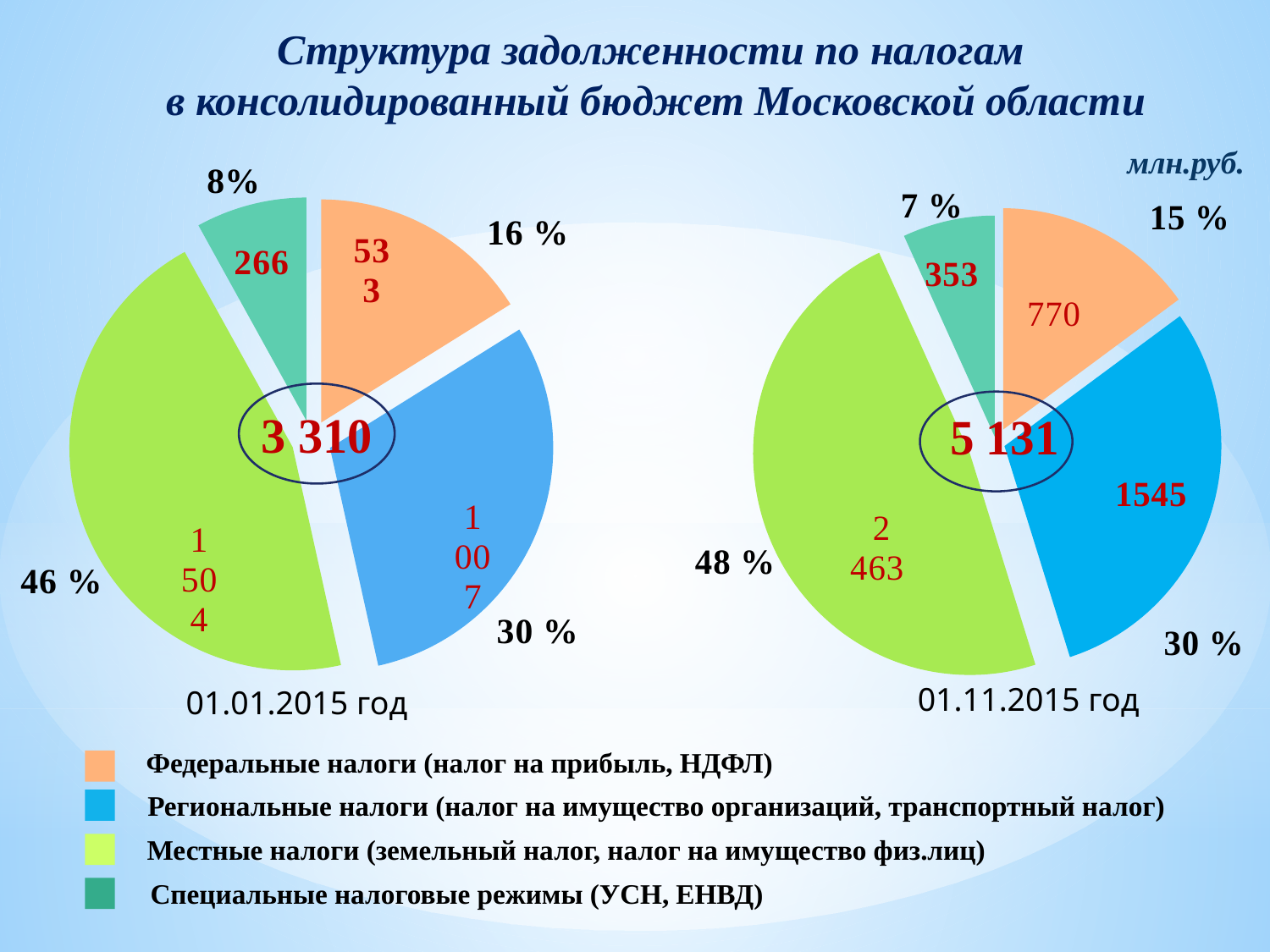
In the 01.11.2015 pie chart, what is the total shown in the centre? 5 131 In the 01.01.2015 pie chart, what share does Специальные налоговые режимы have? 8% In the 01.11.2015 pie chart, which category has the smallest slice? Специальные налоговые режимы In the 01.01.2015 pie chart, which category has the largest slice? Местные налоги In the 01.11.2015 pie chart, what share does Местные налоги have? 48 % Which is larger: Федеральные налоги in the 01.01.2015 chart or Федеральные налоги in the 01.11.2015 chart? 01.11.2015 In the 01.01.2015 pie chart, what is the value for Федеральные налоги? 533 In the 01.01.2015 pie chart, what is the total shown in the centre? 3 310 How many categories does the legend list? 4 What is the difference between the Специальные налоговые режимы values in the 01.11.2015 and 01.01.2015 pie charts? 87 In the 01.11.2015 pie chart, what is the value for Специальные налоговые режимы? 353 In the 01.11.2015 pie chart, what is the value for Региональные налоги? 1545